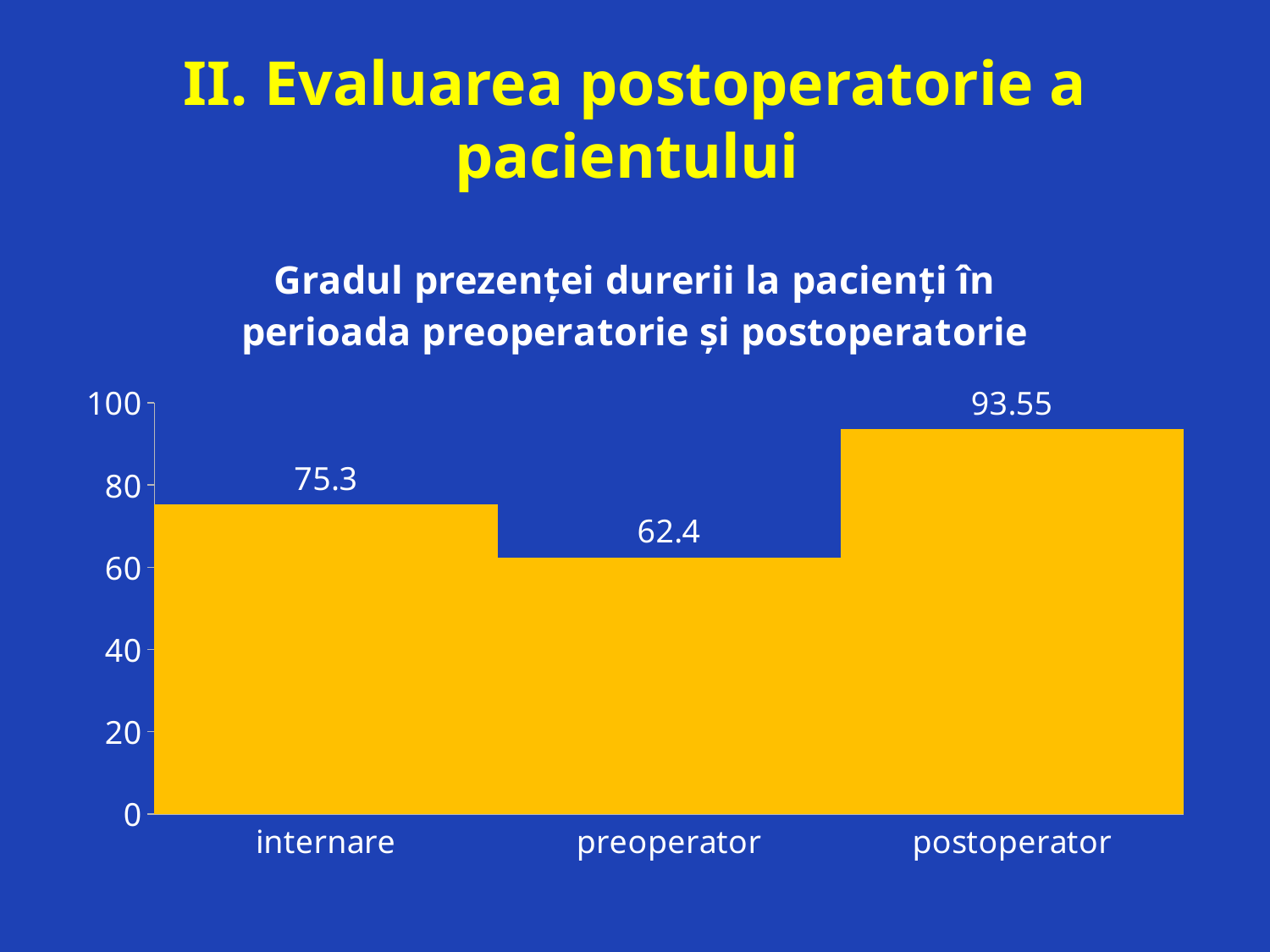
Which category has the highest value? postoperator What is the title of the chart? Gradul prezenței durerii la pacienți în perioada preoperatorie și postoperatorie What is the value for internare? 75.3 Is the value for postoperator greater or less than 80? greater What is the difference between the values for postoperator and internare? 18.25 What kind of chart is shown on the slide? bar chart Which is larger, the value for internare or the value for preoperator? internare Which category has the lowest value? preoperator What is the value for preoperator? 62.4 How many categories are shown on the x axis? 3 What is the value for postoperator? 93.55 What is the difference between the values for internare and preoperator? 12.9